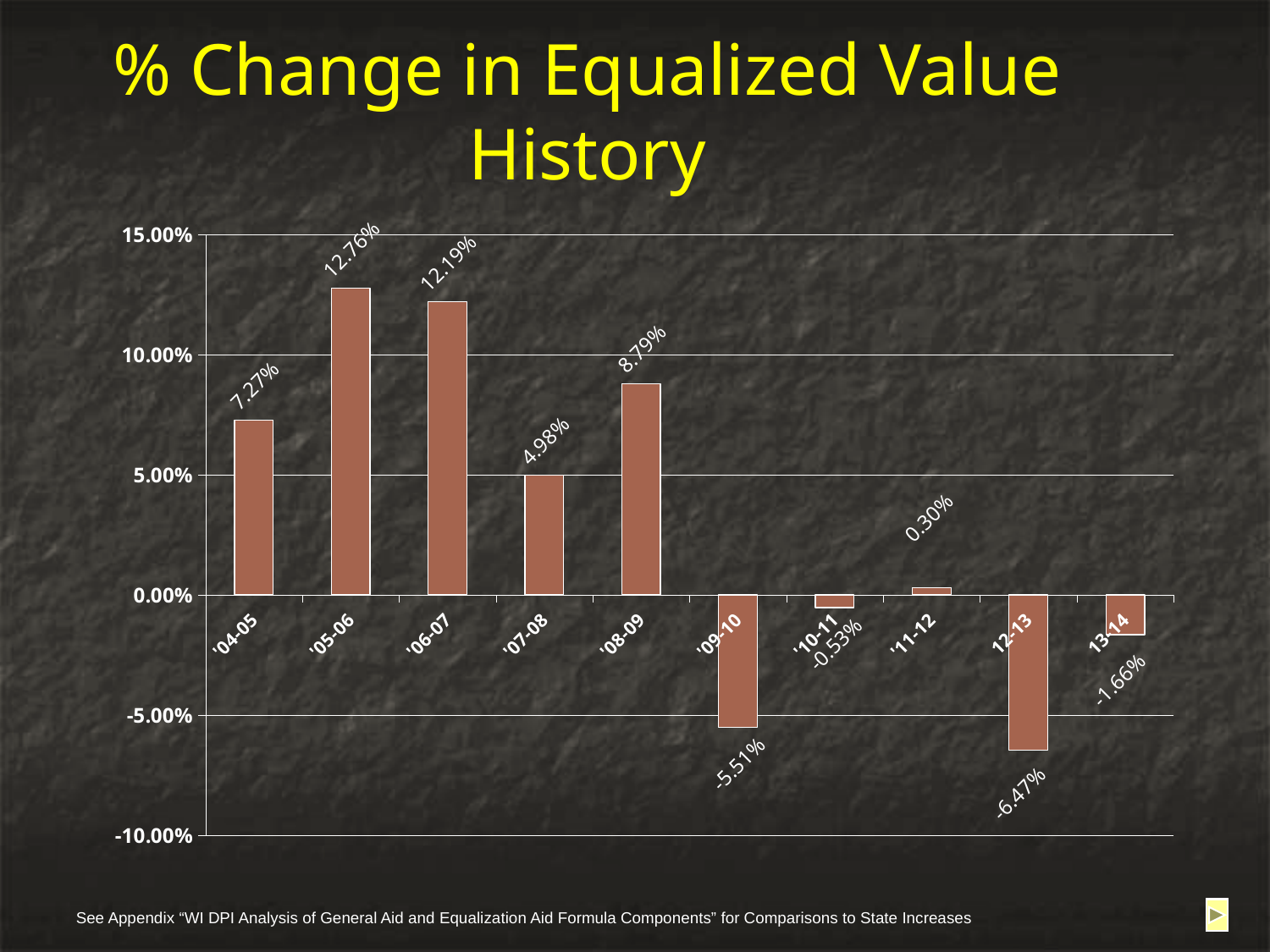
What is the % change in equalized value for '09-10? -5.51% Which year has the highest % change in equalized value? '05-06 What is the title of the chart? % Change in Equalized Value History What is the % change in equalized value for '11-12? 0.30% What kind of chart is shown on the slide? Bar chart How many years are shown on the x axis? 10 What is the difference between the % change for '05-06 and '06-07? 0.57% Which is larger, the % change for '04-05 or '08-09? '08-09 What is the % change in equalized value for '13-14? -1.66% Is the value for '07-08 greater or less than 5.00%? less What is the % change in equalized value for '05-06? 12.76% Which year has the lowest % change in equalized value? '12-13